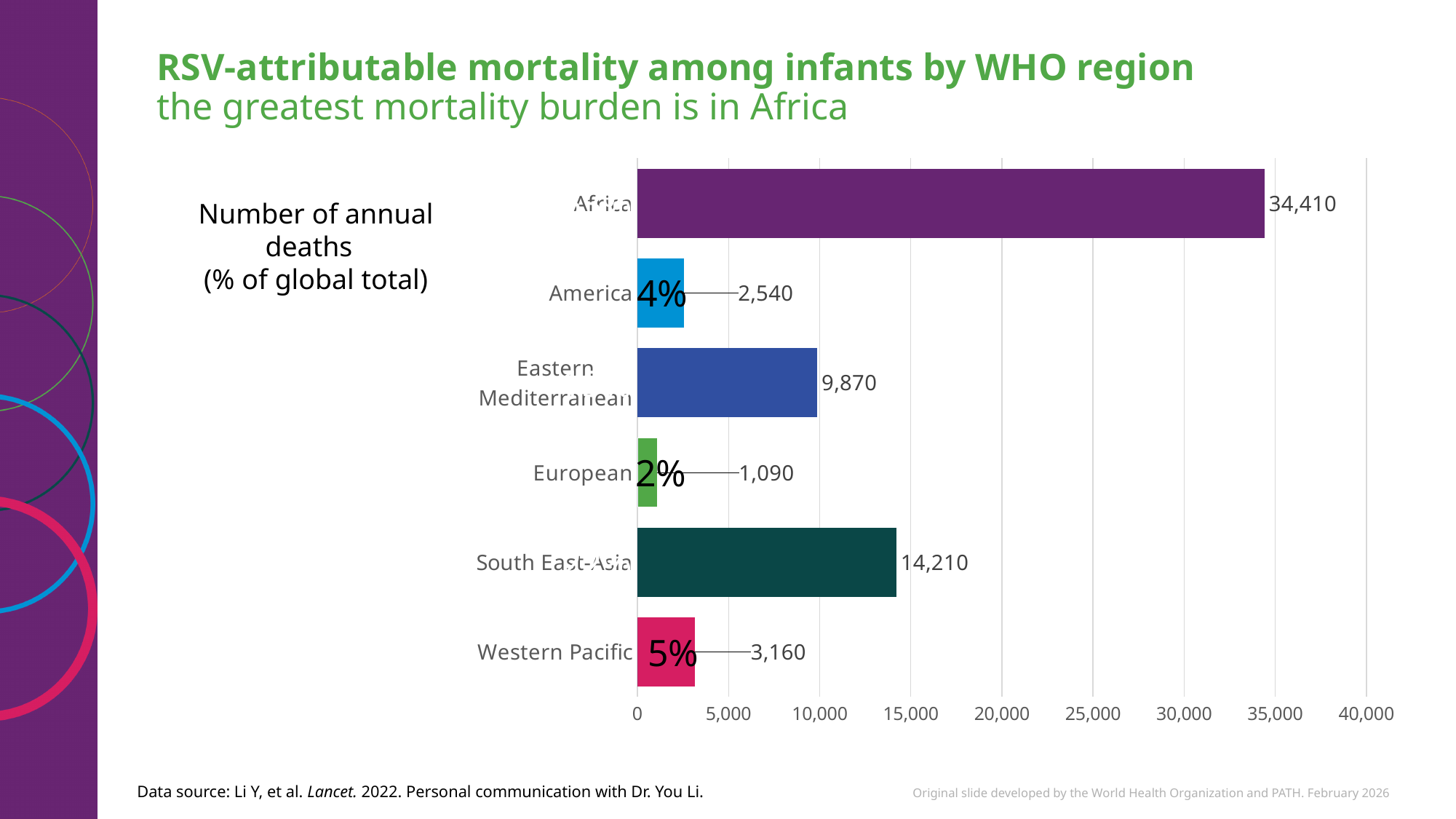
What type of chart is shown on the slide? Bar chart Which region has the highest number of annual deaths? Africa Which region has the lowest number of annual deaths? European What is the difference in annual deaths between Africa and South East-Asia? 20,200 What is the number of annual deaths for South East-Asia? 14,210 What is the number of annual deaths for the Eastern Mediterranean region? 9,870 Which has more annual deaths, America or Western Pacific? Western Pacific Is the value for Eastern Mediterranean greater or less than 10,000? less What percentage of the global total is shown for the European region? 2% How many WHO regions are shown in the chart? 6 What percentage of the global total is shown for the Western Pacific region? 5% What is the number of annual deaths for Africa? 34,410